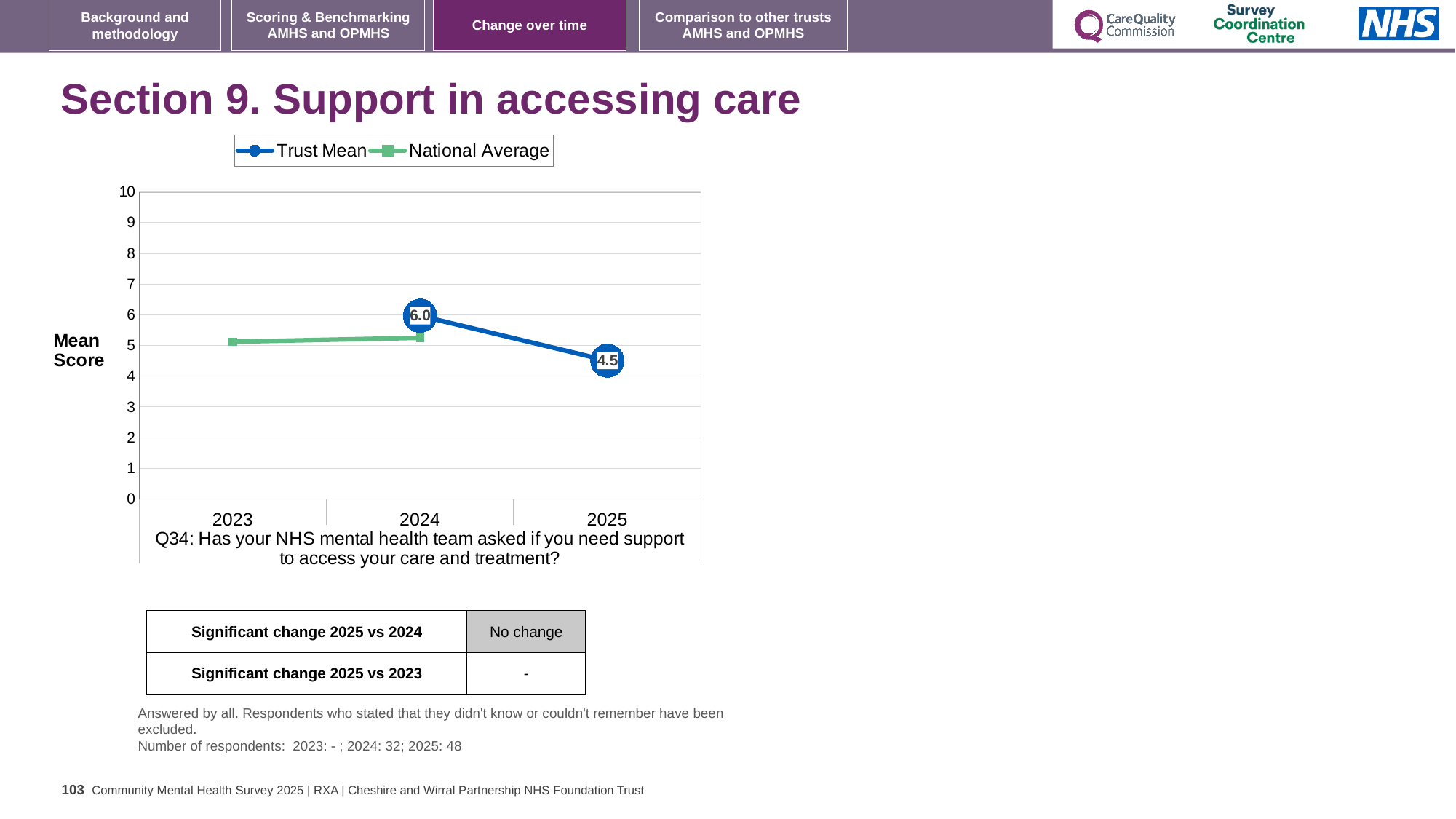
What is the difference between the Trust Mean scores for 2024 and 2025? 1.5 What kind of chart is shown on the slide? line chart How many series does the legend list? 2 What is the label on the y axis of the chart? Mean Score Does the Trust Mean rise or fall from 2024 to 2025? fall Which year has the higher Trust Mean score, 2024 or 2025? 2024 What is the Trust Mean score for 2025? 4.5 How many years are shown on the x axis? 3 In 2024, which is higher, the Trust Mean or the National Average? Trust Mean What is the Trust Mean score for 2024? 6.0 Is the National Average value for 2024 greater or less than 4? greater Is the National Average value for 2023 greater or less than 6? less